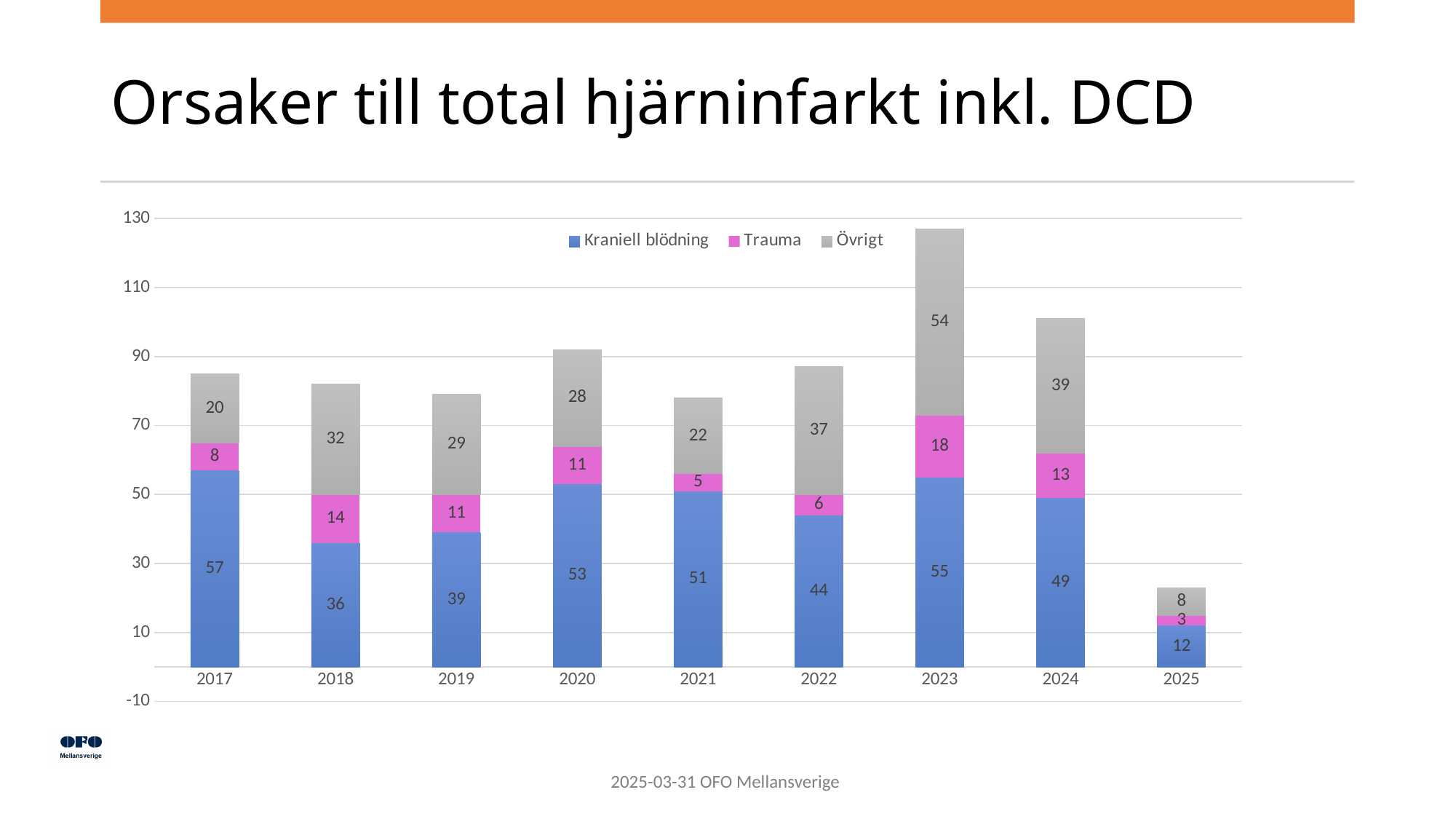
Which is larger, the Trauma value for 2018 or the Trauma value for 2021? 2018 What is the total of the stacked bar for 2023? 127 What is the title of the chart? Orsaker till total hjärninfarkt inkl. DCD What is the value for Övrigt in 2022? 37 What kind of chart is shown on the slide? Stacked bar chart What is the value for Trauma in 2023? 18 How many years are shown on the x axis? 9 Which year has the lowest value for Kraniell blödning? 2025 What is the difference between the Kraniell blödning values for 2017 and 2018? 21 What is the value for Kraniell blödning in 2017? 57 How many series does the legend list? 3 Which year has the highest value for Övrigt? 2023